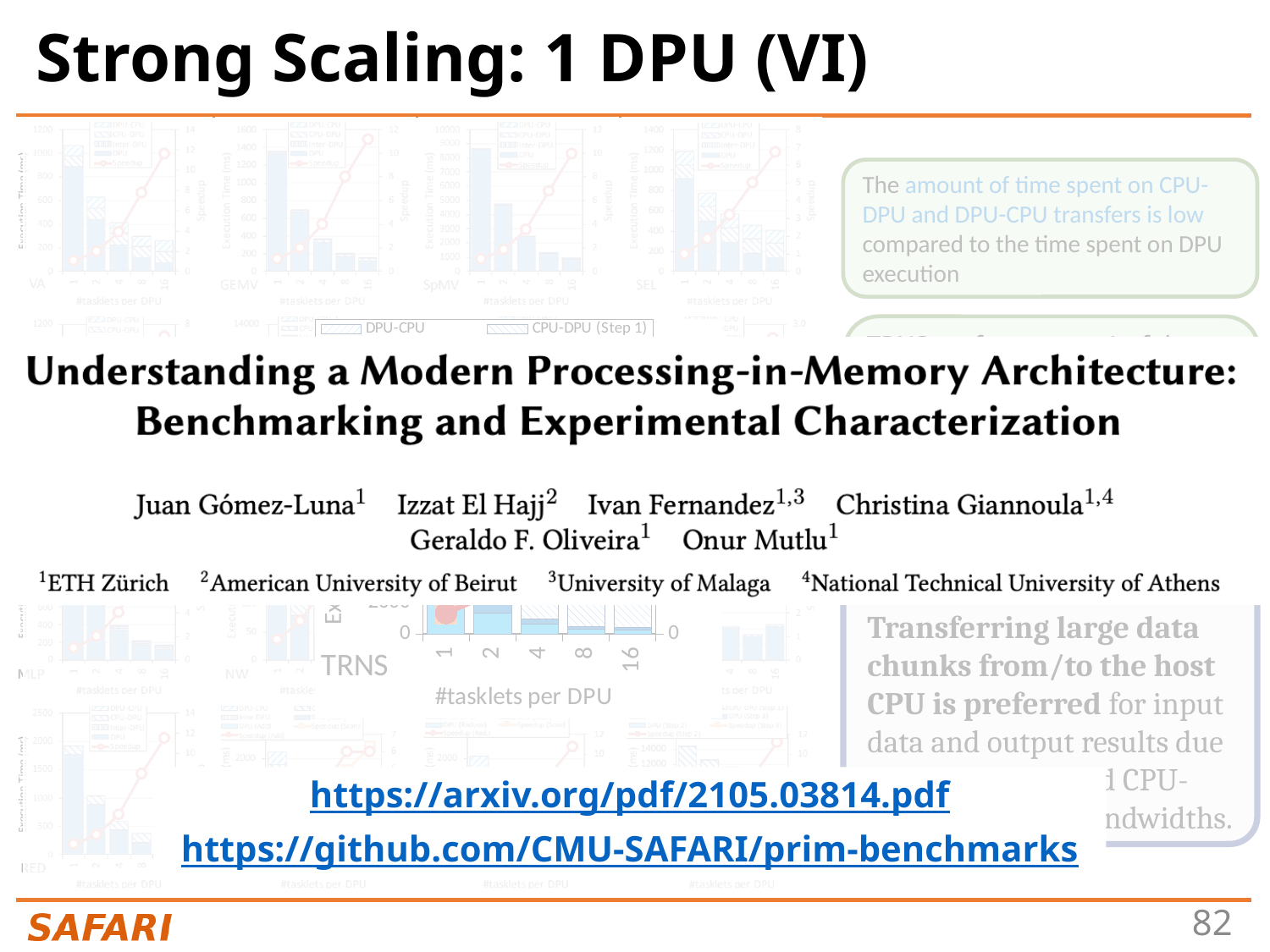
What are the two legend entries shown in the legend strip below the top row of charts? DPU-CPU and CPU-DPU (Step 1) In the VA chart at the top left, is the execution time bar for 16 tasklets per DPU greater or less than 800? less In the VA chart at the top left, what is the x-axis label? #tasklets per DPU In the SpMV chart at the top, which tasklet count has the highest execution time bar? 1 In the VA chart at the top left, how many tasklet counts are shown along the x axis? 5 In the VA chart at the top left, which tasklet count has the highest execution time bar? 1 In the GEMV chart at the top, does the Speedup line rise or fall as the number of tasklets per DPU increases? rises In the GEMV chart at the top, is the execution time bar for 1 tasklet per DPU greater or less than 1000? greater In the SpMV chart at the top, is the execution time bar for 1 tasklet per DPU greater or less than 5000? greater What kind of chart is the VA chart at the top left? bar chart with a line In the VA chart at the top left, does the Speedup line rise or fall as the number of tasklets per DPU increases? rises